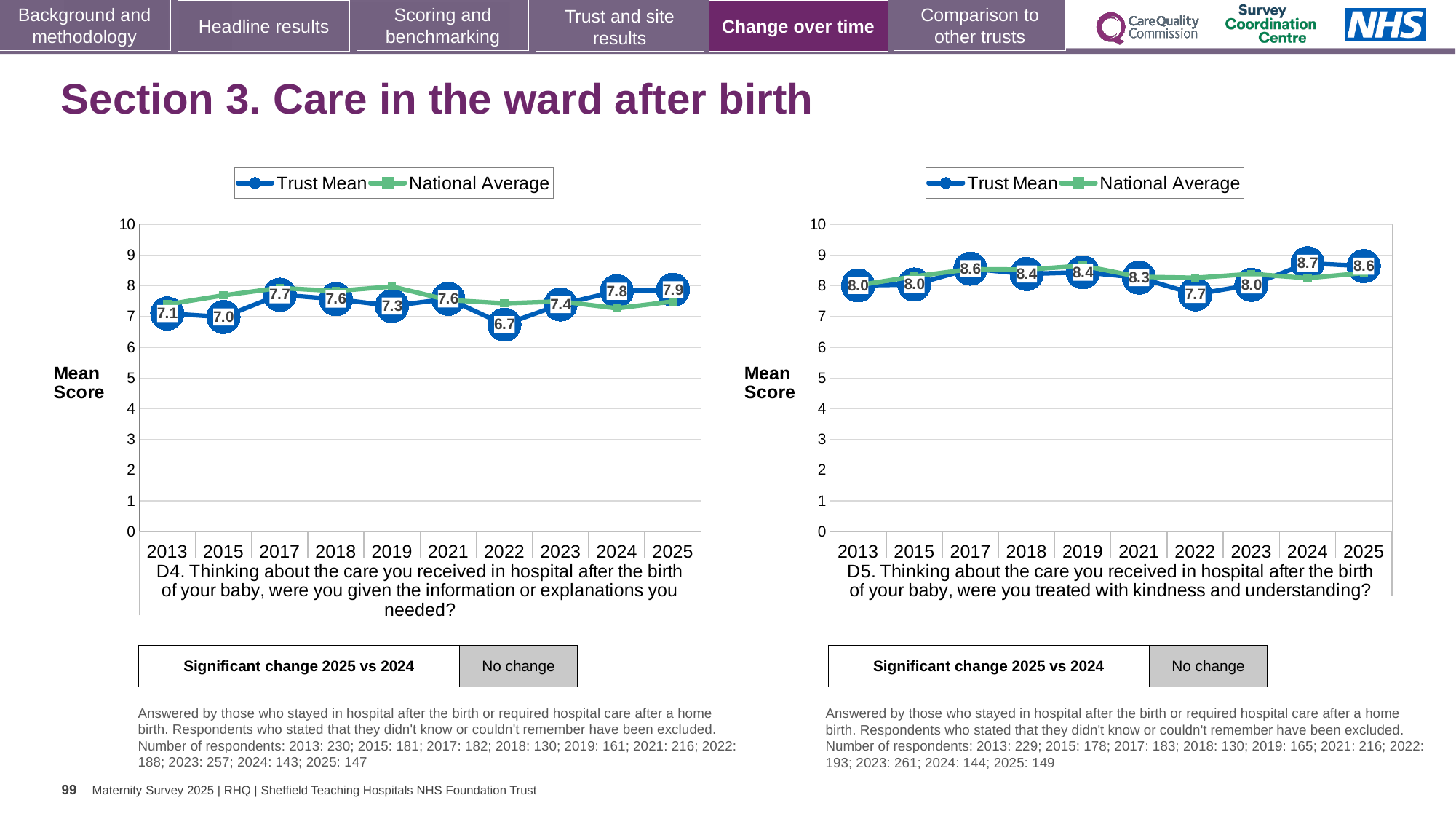
On the D5 chart (right), which year has the lowest Trust Mean score? 2022 How many series does the legend of the D4 chart (left) list? 2 On the D4 chart (left), what is the Trust Mean score for 2025? 7.9 On the D5 chart (right), which year has the highest Trust Mean score? 2024 On the D4 chart (left), which year has the highest Trust Mean score? 2025 On the D5 chart (right), is the Trust Mean score for 2017 or 2022 larger? 2017 On the D5 chart (right), what is the Trust Mean score for 2024? 8.7 What kind of chart is the D4 chart (left)? Line chart How many years are plotted on the D5 chart (right)? 10 On the D4 chart (left), what is the Trust Mean score for 2022? 6.7 On the D4 chart (left), what is the difference between the Trust Mean scores for 2025 and 2024? 0.1 On the D4 chart (left), which year has the lowest Trust Mean score? 2022